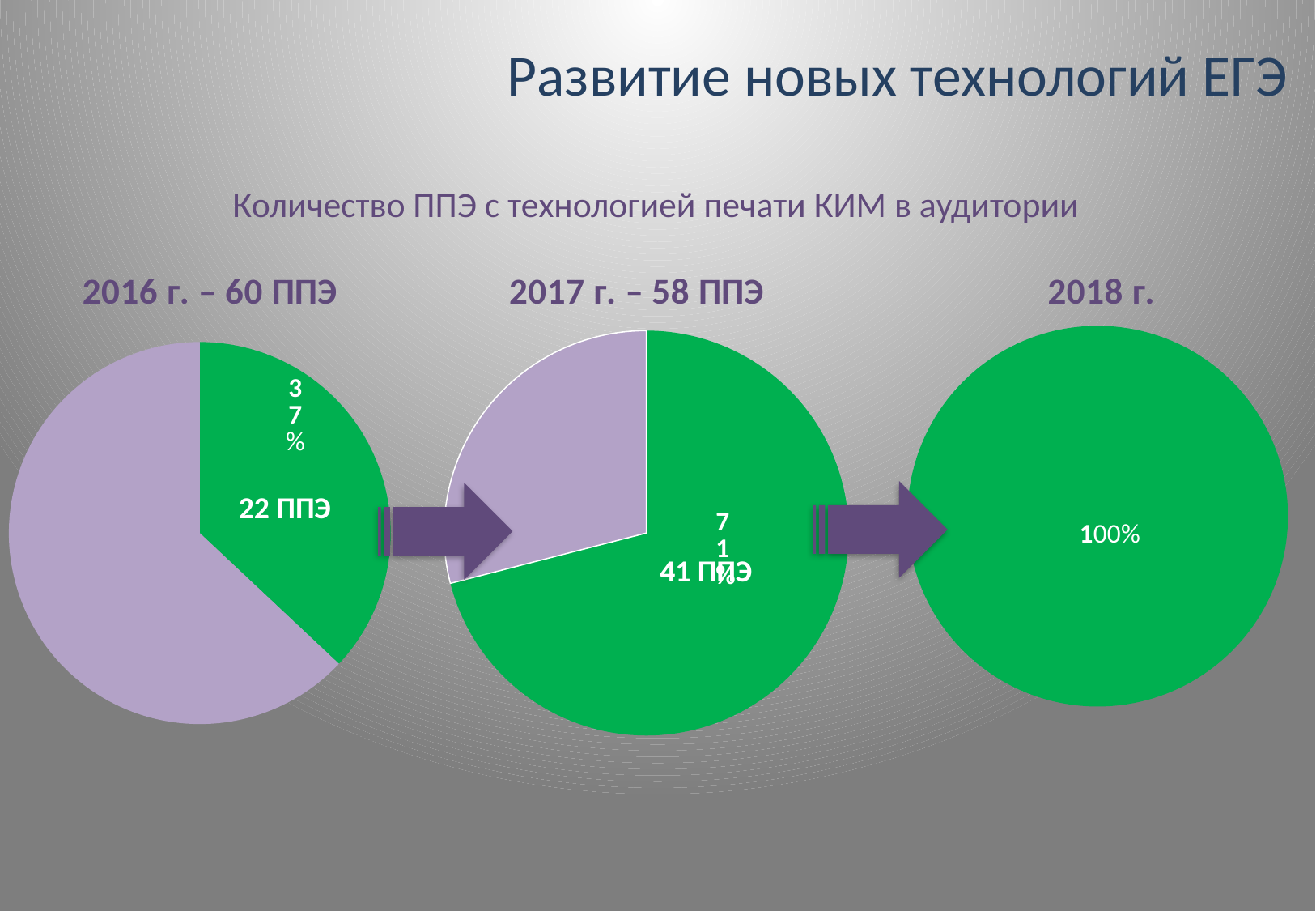
Does the share of ППЭ with the technology rise or fall from 2016 to 2018 across the charts? Rise In the 2016 pie chart, what percentage does the green slice represent? 37% How many pie charts are on the slide? 3 What kind of charts are shown on the slide? Pie charts In the 2016 pie chart, how many ППЭ does the green slice correspond to? 22 ППЭ How many slices does the 2016 pie chart have? 2 In the 2017 pie chart, how many ППЭ does the green slice correspond to? 41 ППЭ In the 2017 pie chart, what percentage does the green slice represent? 71% By how many ППЭ did the number with the technology increase from the 2016 chart to the 2017 chart? 19 ППЭ What is the difference in percentage points between the green slice in the 2017 chart and the green slice in the 2016 chart? 34 percentage points Which chart has the larger green share, the 2016 chart or the 2017 chart? 2017 In the 2018 pie chart, what percentage is shown for the green slice? 100%